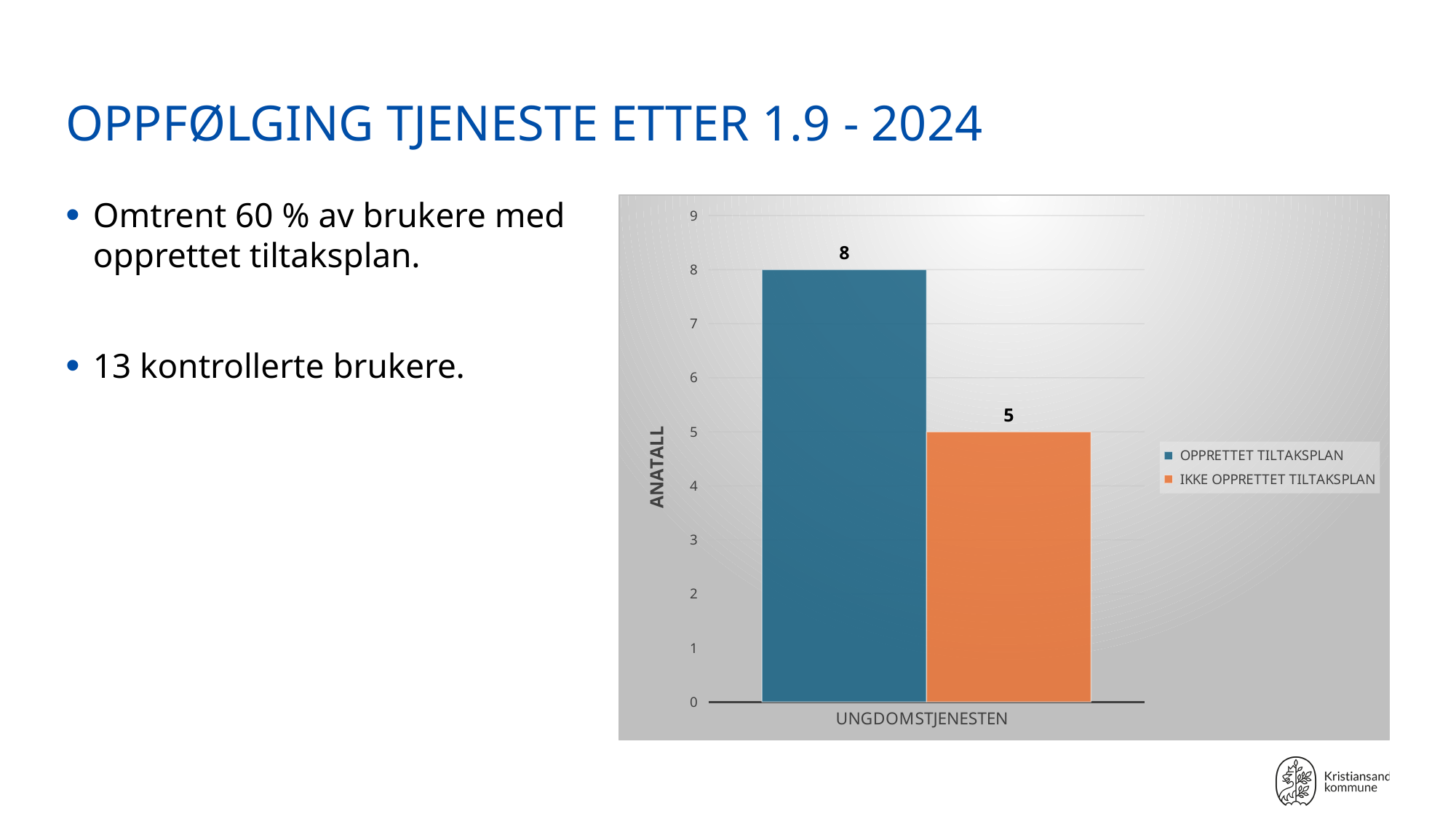
Which series has the lower value in the chart? IKKE OPPRETTET TILTAKSPLAN What is the value for IKKE OPPRETTET TILTAKSPLAN in the chart? 5 Is the value for OPPRETTET TILTAKSPLAN larger or smaller than the value for IKKE OPPRETTET TILTAKSPLAN? larger What is the value for OPPRETTET TILTAKSPLAN in the chart? 8 Is the value for IKKE OPPRETTET TILTAKSPLAN greater or less than 6? less How many categories are shown on the x axis of the chart? 1 Which series has the higher value in the chart? OPPRETTET TILTAKSPLAN What is the label of the category on the x axis? UNGDOMSTJENESTEN How many series does the legend list? 2 What is the label of the y axis? ANATALL What kind of chart is shown on the slide? bar chart What is the difference between the values for OPPRETTET TILTAKSPLAN and IKKE OPPRETTET TILTAKSPLAN? 3